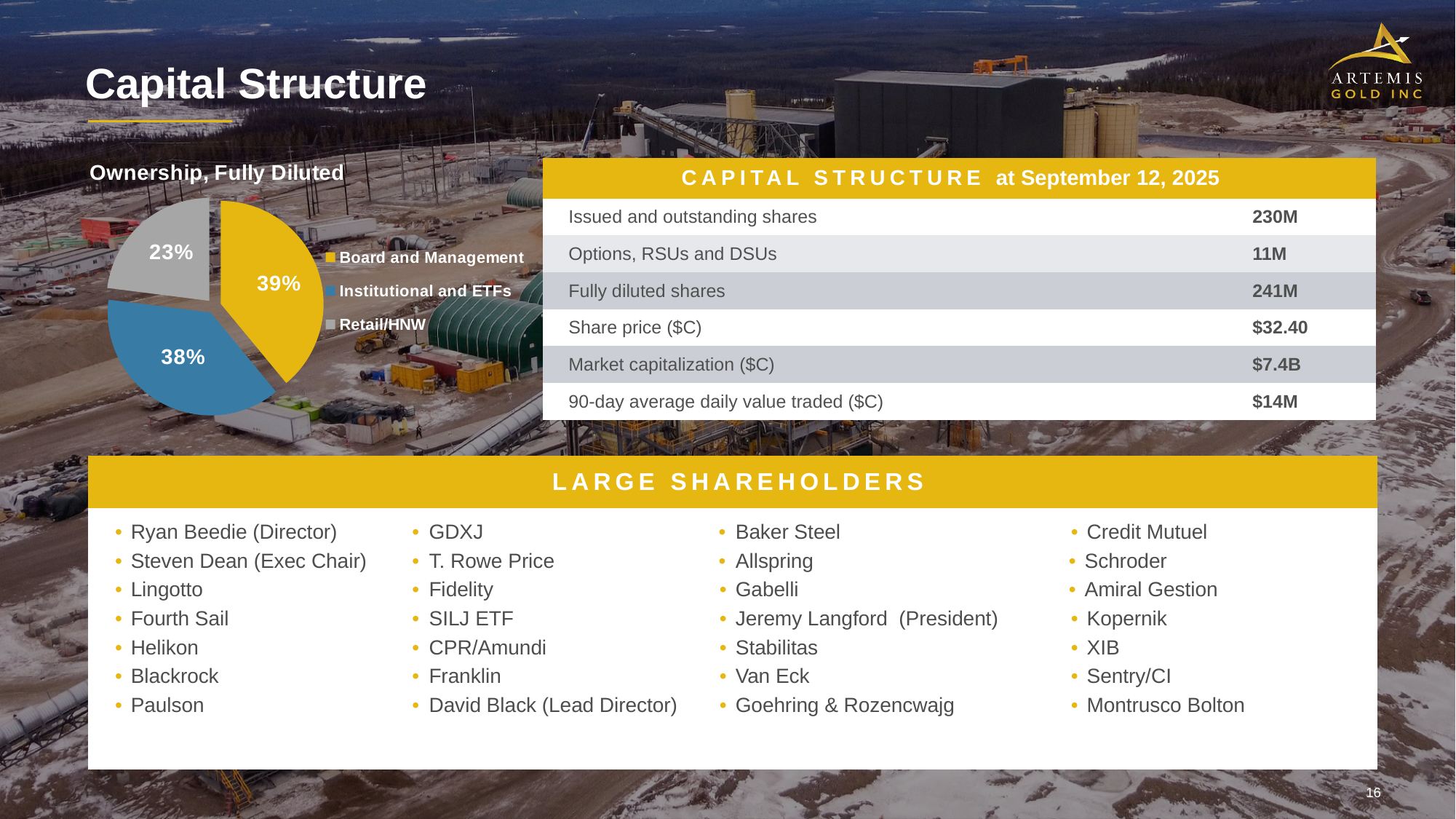
What colour is the Institutional and ETFs slice in the "Ownership, Fully Diluted" pie chart? blue How many slices does the "Ownership, Fully Diluted" pie chart have? 3 In the "Ownership, Fully Diluted" pie chart, which is larger: Institutional and ETFs or Retail/HNW? Institutional and ETFs What share of the "Ownership, Fully Diluted" pie is Institutional and ETFs? 38% Which category has the smallest slice in the "Ownership, Fully Diluted" pie chart? Retail/HNW What share of the "Ownership, Fully Diluted" pie is Retail/HNW? 23% What kind of chart is the "Ownership, Fully Diluted" chart? pie chart What share of the "Ownership, Fully Diluted" pie is Board and Management? 39% How many entries does the legend of the "Ownership, Fully Diluted" pie chart list? 3 Which category has the largest slice in the "Ownership, Fully Diluted" pie chart? Board and Management In the "Ownership, Fully Diluted" pie chart, what is the difference in percentage points between Board and Management and Retail/HNW? 16 In the "Ownership, Fully Diluted" pie chart, what is the difference in percentage points between Institutional and ETFs and Retail/HNW? 15